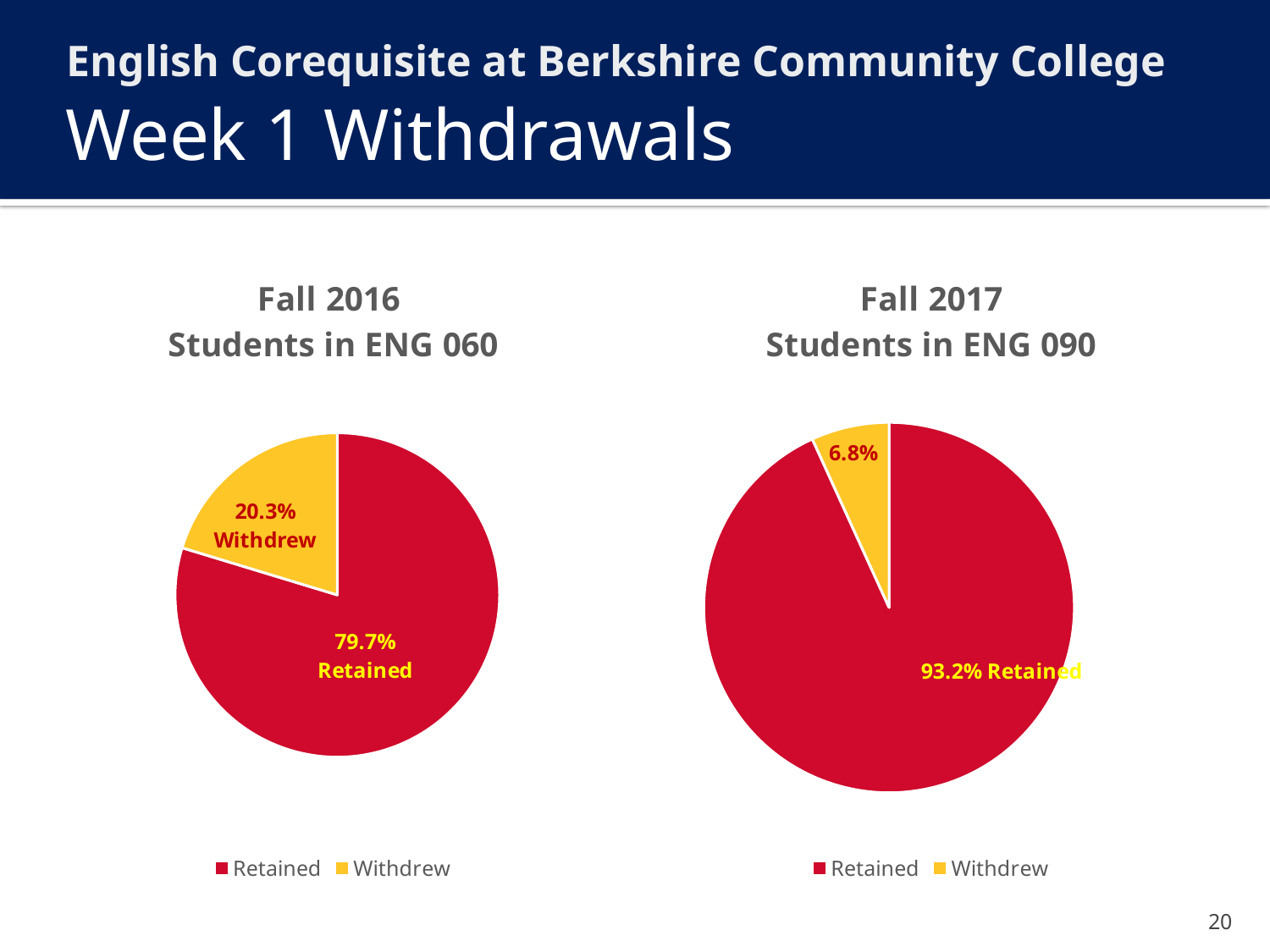
In the Fall 2017 Students in ENG 090 chart, what colour is the Withdrew slice? Yellow In the Fall 2016 Students in ENG 060 chart, what share of students were retained? 79.7% In the Fall 2016 Students in ENG 060 chart, what share of students withdrew? 20.3% What kind of chart is the Fall 2016 Students in ENG 060 chart? Pie chart How many slices does the Fall 2017 Students in ENG 090 pie chart have? 2 In the Fall 2017 Students in ENG 090 chart, which slice is the smallest? Withdrew In the Fall 2017 Students in ENG 090 chart, what share of students were retained? 93.2% How many entries does the legend of the Fall 2016 Students in ENG 060 chart list? 2 In the Fall 2016 Students in ENG 060 chart, which slice is larger, Retained or Withdrew? Retained In the Fall 2017 Students in ENG 090 chart, what percentage is shown on the Withdrew slice? 6.8% What is the difference between the Retained share in the Fall 2017 Students in ENG 090 chart and the Retained share in the Fall 2016 Students in ENG 060 chart? 13.5% Which chart has the larger Withdrew share, Fall 2016 Students in ENG 060 or Fall 2017 Students in ENG 090? Fall 2016 Students in ENG 060